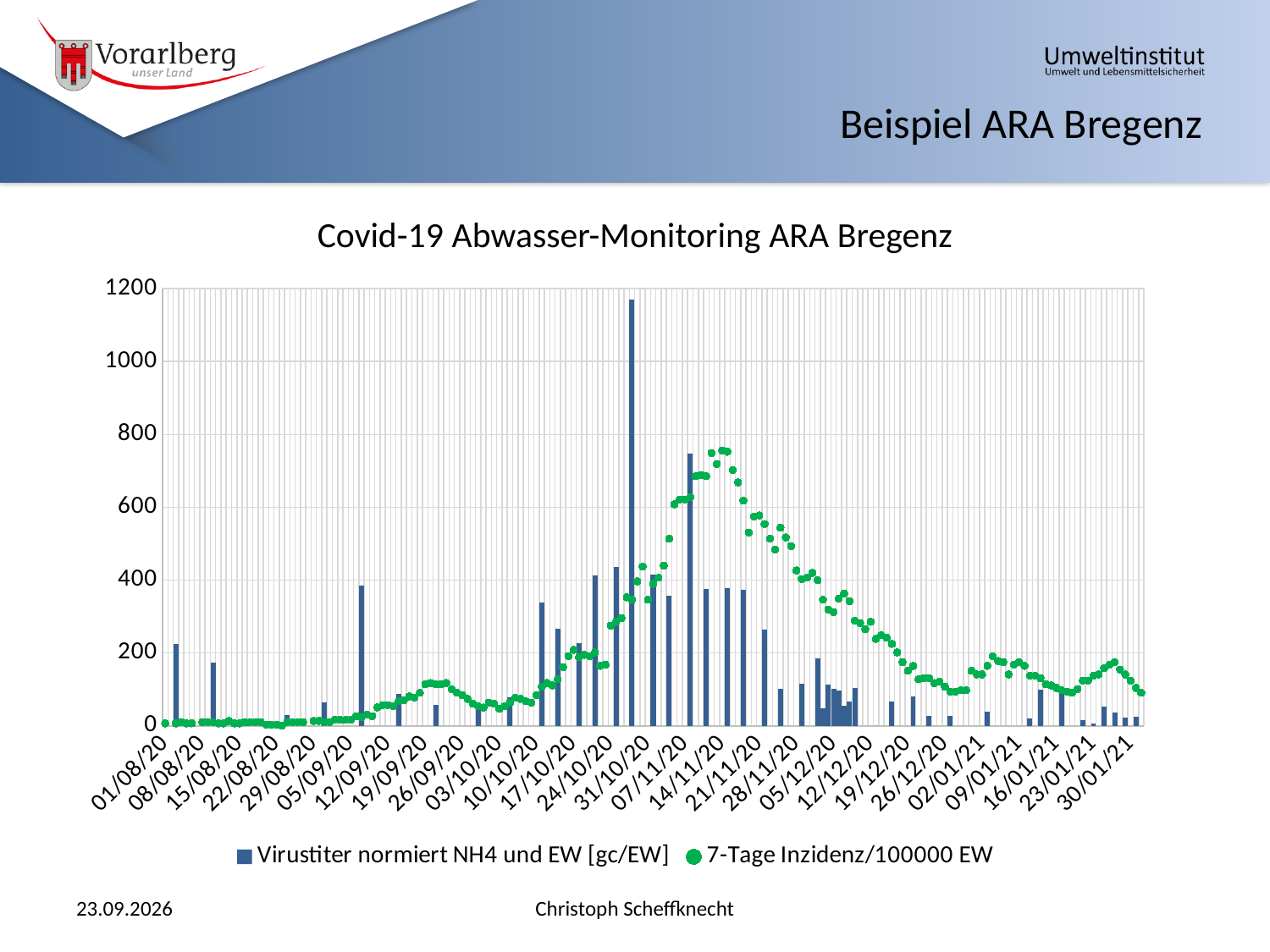
Is the peak of the 7-Tage Inzidenz/100000 EW series greater or less than 800? less What is the highest value shown on the y axis of the chart? 1200 How many date labels are shown on the x axis of the chart? 27 Is the peak of the 7-Tage Inzidenz/100000 EW series greater or less than 600? greater Is the tallest bar for Virustiter normiert NH4 und EW greater or less than 1000? greater Which series is shown as green dots in the chart? 7-Tage Inzidenz/100000 EW Does the 7-Tage Inzidenz/100000 EW series rise or fall between 14/11/20 and 26/12/20? fall What kind of chart is shown on the slide? A bar chart combined with a dotted line series Which series reaches the higher peak value, Virustiter normiert NH4 und EW or 7-Tage Inzidenz/100000 EW? Virustiter normiert NH4 und EW How many series does the chart legend list? 2 What is the title of the chart? Covid-19 Abwasser-Monitoring ARA Bregenz